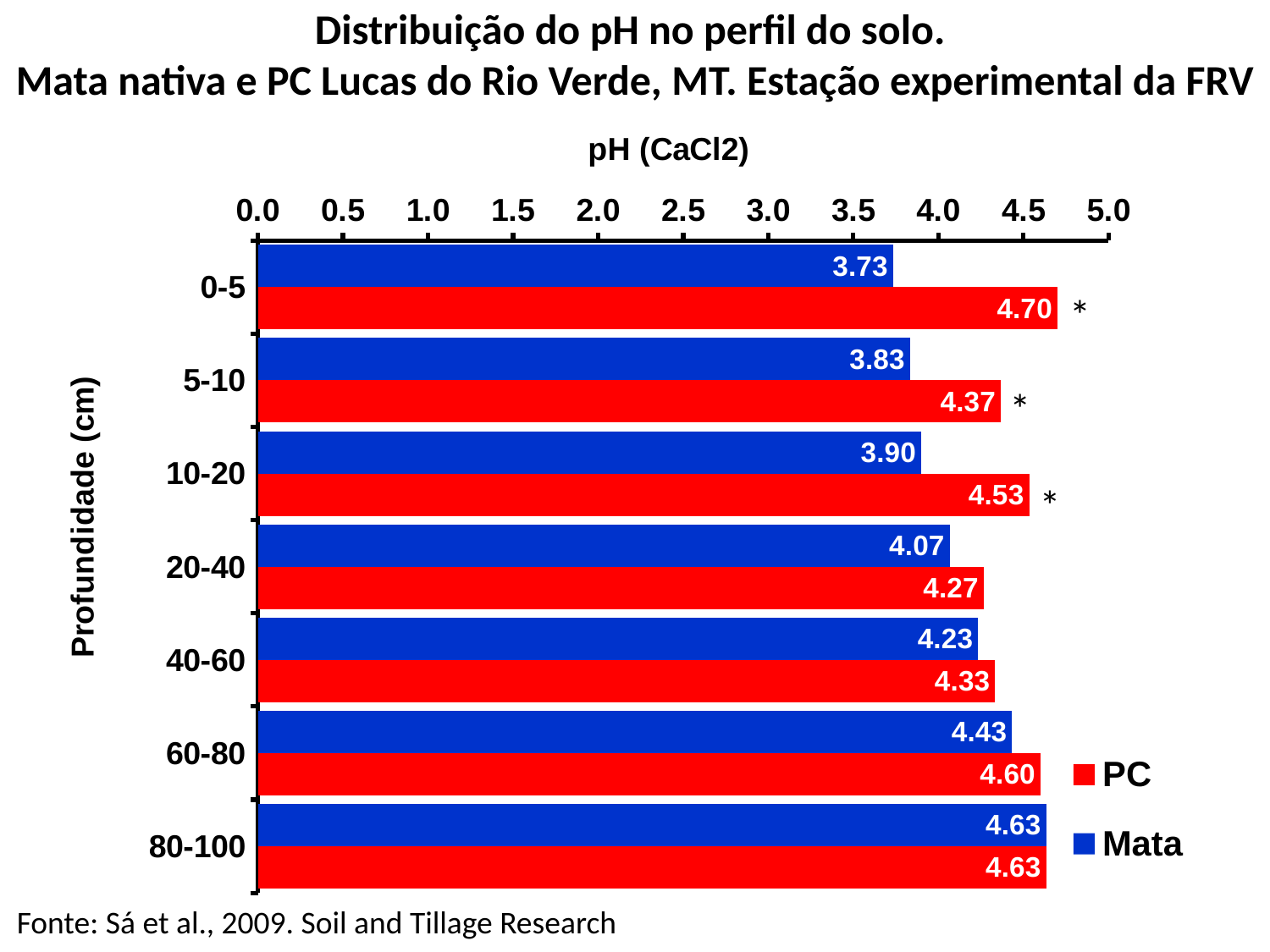
Which colour represents the Mata series? blue What is the pH value for PC at the 5-10 cm depth? 4.37 How many depth categories are shown on the chart? 7 What kind of chart is shown on the slide? bar chart How many series does the legend list? 2 What is the pH value for Mata at the 0-5 cm depth? 3.73 At which depth is the Mata pH value lowest? 0-5 What is the pH value for PC at the 80-100 cm depth? 4.63 Which is larger at the 20-40 cm depth, the PC value or the Mata value? PC Is the Mata value at the 10-20 cm depth greater or less than 4.0? less At which depth is the PC pH value highest? 0-5 What is the difference between the PC and Mata pH values at the 0-5 cm depth? 0.97